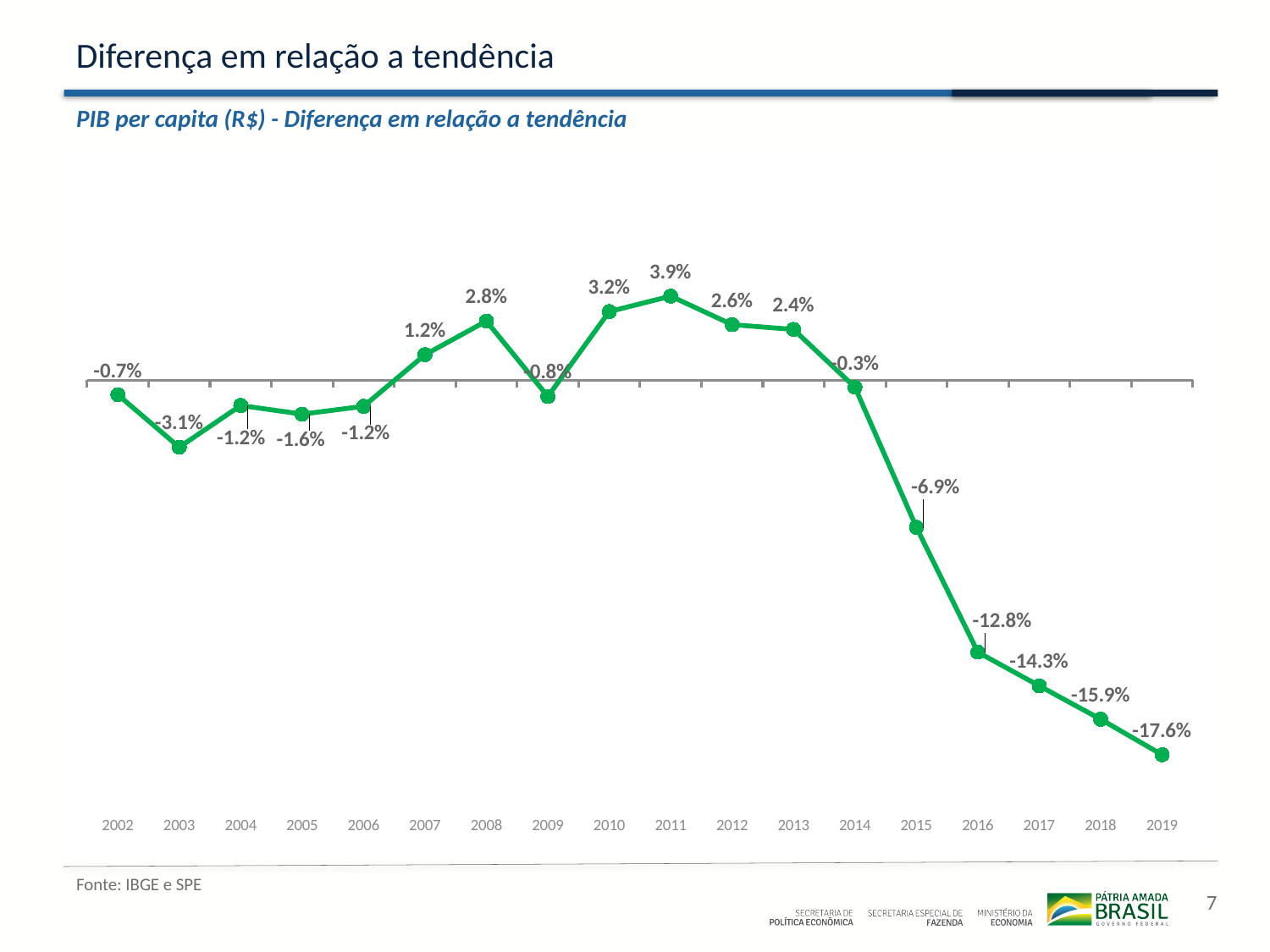
What kind of chart is shown? Line chart What is the difference between the values for 2016 and 2017? 1.5 percentage points What is the title of the chart? PIB per capita (R$) - Diferença em relação a tendência Which is larger, the value for 2008 or the value for 2010? 2010 Which year has the highest value? 2011 What is the value for 2011? 3.9% Which year has the lowest value? 2019 What is the value for 2015? -6.9% What is the value for 2019? -17.6% Do the values rise or fall from 2014 to 2019? Fall What is the value for 2003? -3.1% How many years are plotted on the chart? 18